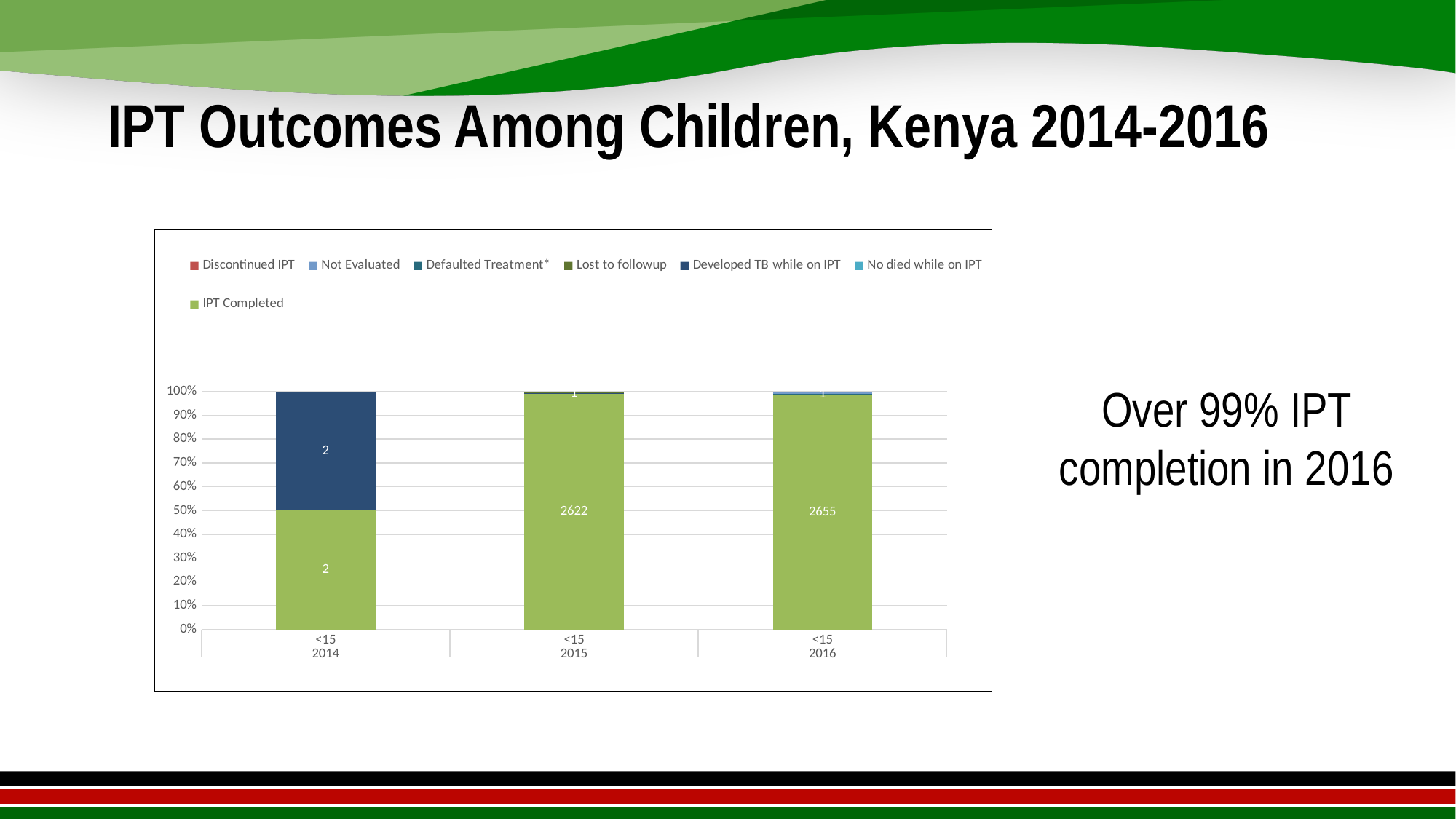
What is the value of IPT Completed for <15 in 2014? 2 What is the value of IPT Completed for <15 in 2015? 2622 What is the value of IPT Completed for <15 in 2016? 2655 Is the share of the 2015 bar taken by IPT Completed greater or less than 90%? greater In which year is the IPT Completed value highest? 2016 How many year categories are shown on the x axis? 3 What is the value of Developed TB while on IPT for <15 in 2014? 2 In which year is the IPT Completed value lowest? 2014 Which year has a larger IPT Completed value, 2015 or 2016? 2016 How many series does the legend list? 7 What is the difference between the IPT Completed values for 2016 and 2015? 33 What kind of chart is shown on the slide? Stacked bar chart